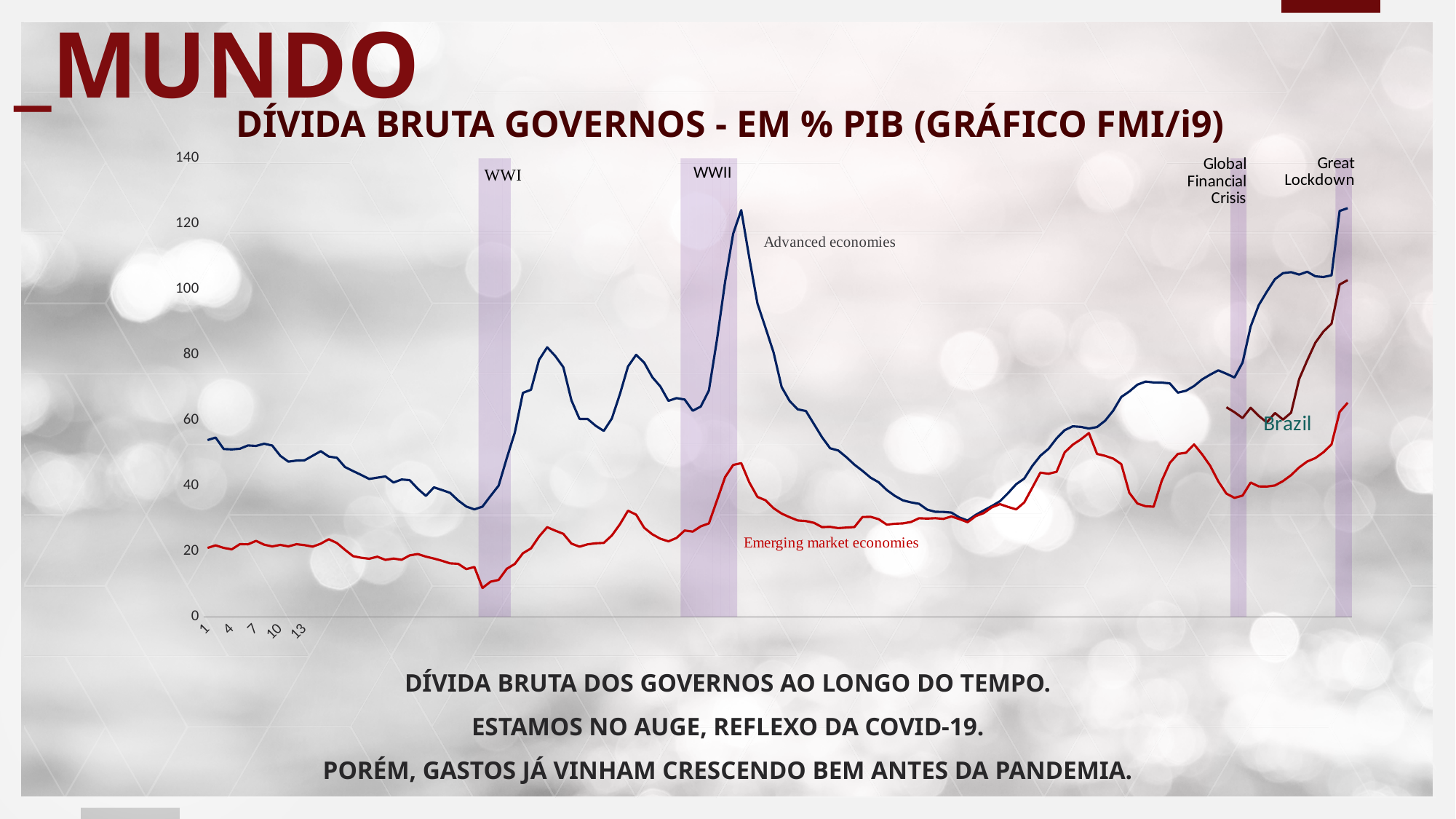
What is the title of the chart? DÍVIDA BRUTA GOVERNOS - EM % PIB (GRÁFICO FMI/i9) Is the final value of the Emerging market economies line at the Great Lockdown greater or less than 40? greater Is the peak value of the Emerging market economies line during WWII greater or less than 60? less At the Great Lockdown, which line is higher: Advanced economies or Emerging market economies? Advanced economies At the Great Lockdown, which line is higher: Brazil or Emerging market economies? Brazil How many data series are plotted on the chart? 3 Does the Advanced economies line rise or fall in the period immediately after its WWII peak? fall Is the final value of the Brazil line at the Great Lockdown greater or less than 80? greater Does the Emerging market economies line rise or fall between the Global Financial Crisis and the Great Lockdown? rise What kind of chart is shown on the slide? line chart